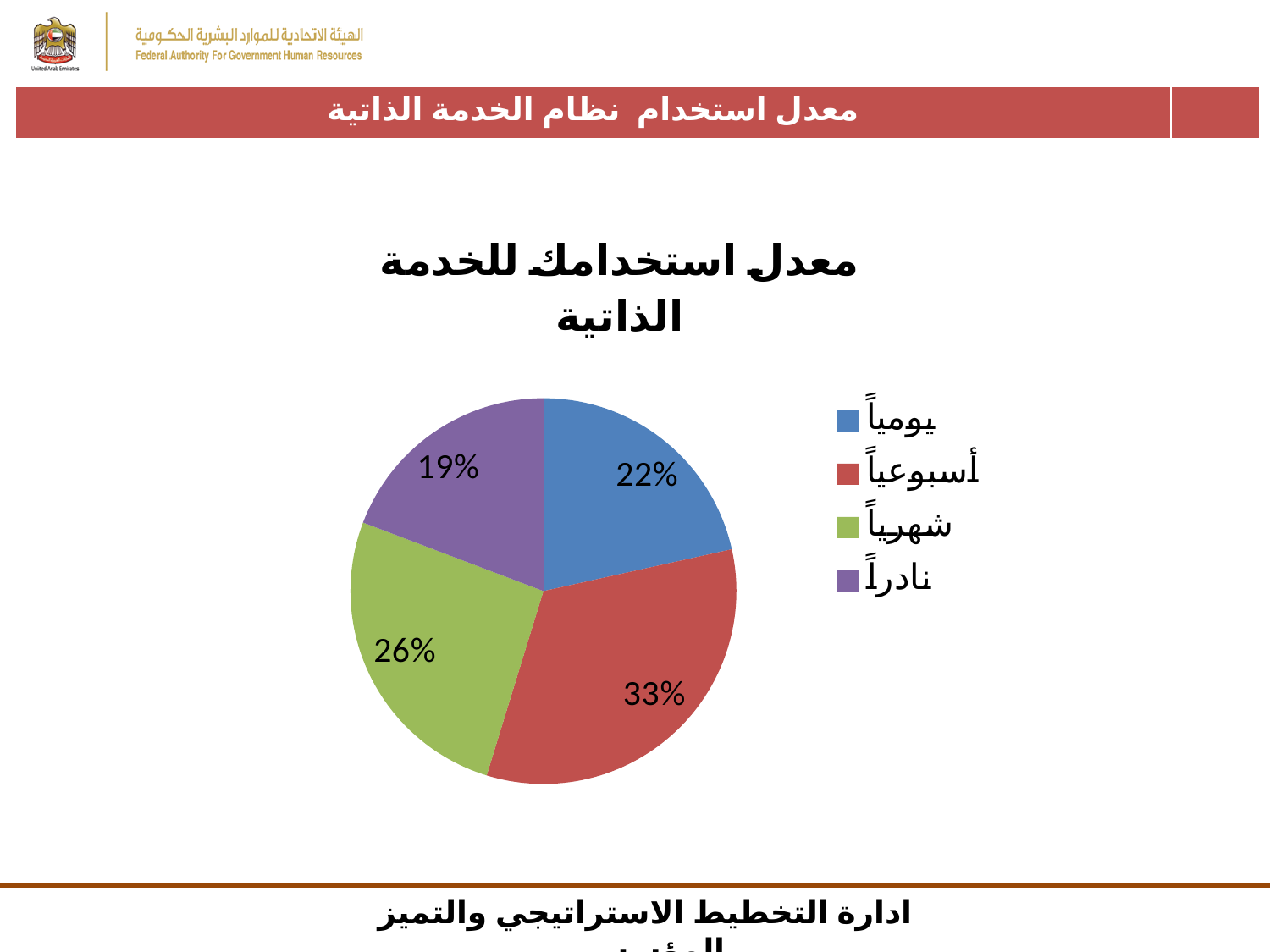
Which category has the largest share of the pie chart? أسبوعياً What is the value for شهرياً (monthly) in the pie chart? 26% What is the value for يومياً (daily) in the pie chart? 22% What is the value for نادراً (rarely) in the pie chart? 19% How many slices does the pie chart have? 4 Which is larger, the share for شهرياً or the share for يومياً? شهرياً What is the value for أسبوعياً (weekly) in the pie chart? 33% What is the difference between the shares for أسبوعياً and نادراً? 14% How many entries does the legend list? 4 Which category has the smallest share of the pie chart? نادراً What colour is the slice for أسبوعياً? Red What type of chart is shown on the slide? Pie chart